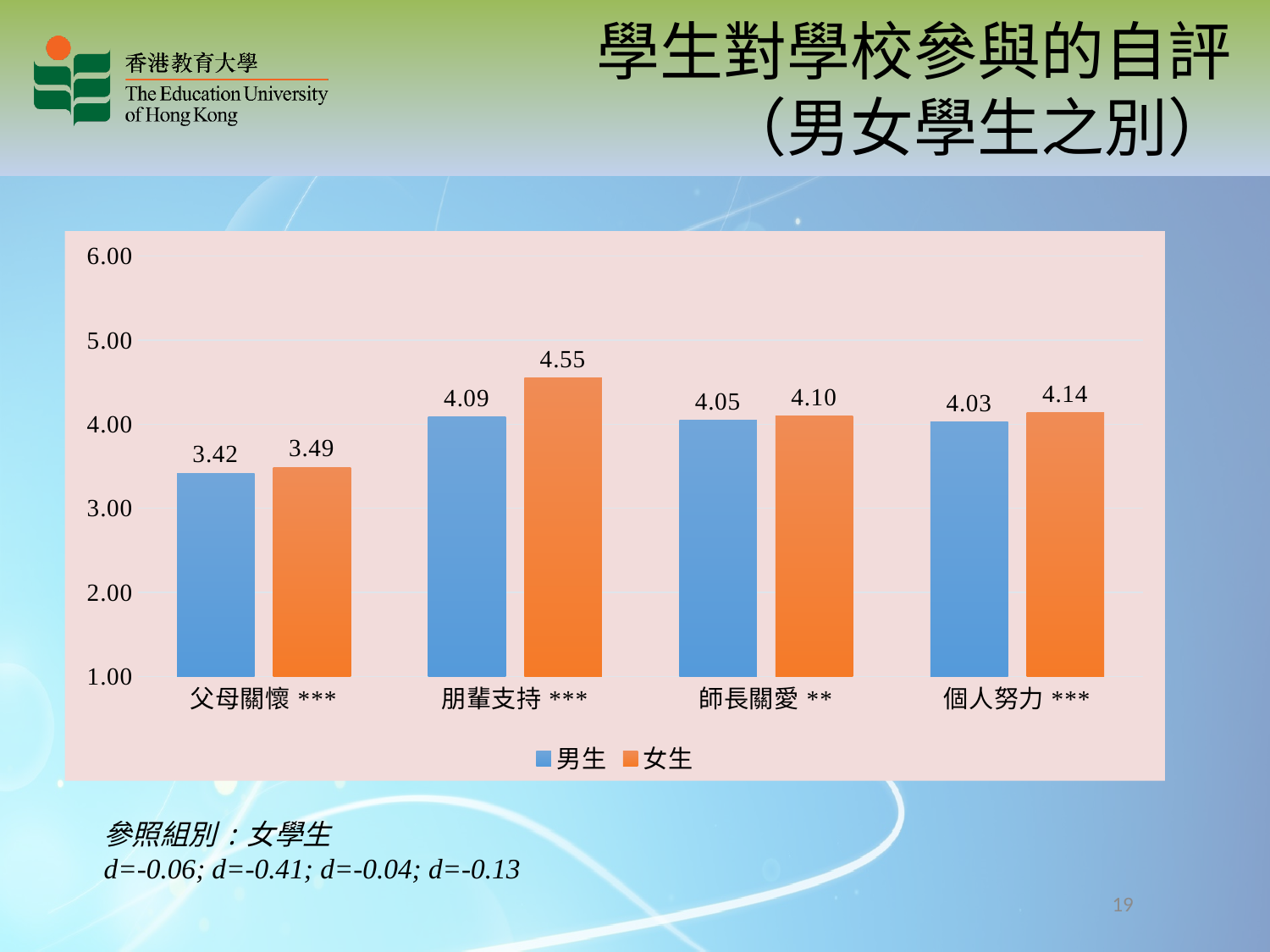
What is the difference between the 女生 and 男生 values in the 朋輩支持 *** category? 0.46 What kind of chart is shown on the slide? bar chart What is the value for 男生 in the 朋輩支持 *** category? 4.09 What is the value for 女生 in the 個人努力 *** category? 4.14 Is the value for 男生 in the 父母關懷 *** category greater or less than 4.00? less In the 父母關懷 *** category, which is larger, the 男生 value or the 女生 value? 女生 Which category has the highest value for 女生? 朋輩支持 *** Which category has the lowest value for 男生? 父母關懷 *** What is the value for 女生 in the 父母關懷 *** category? 3.49 How many series does the legend list? 2 How many categories are shown on the x axis? 4 What is the difference between the 女生 and 男生 values in the 個人努力 *** category? 0.11